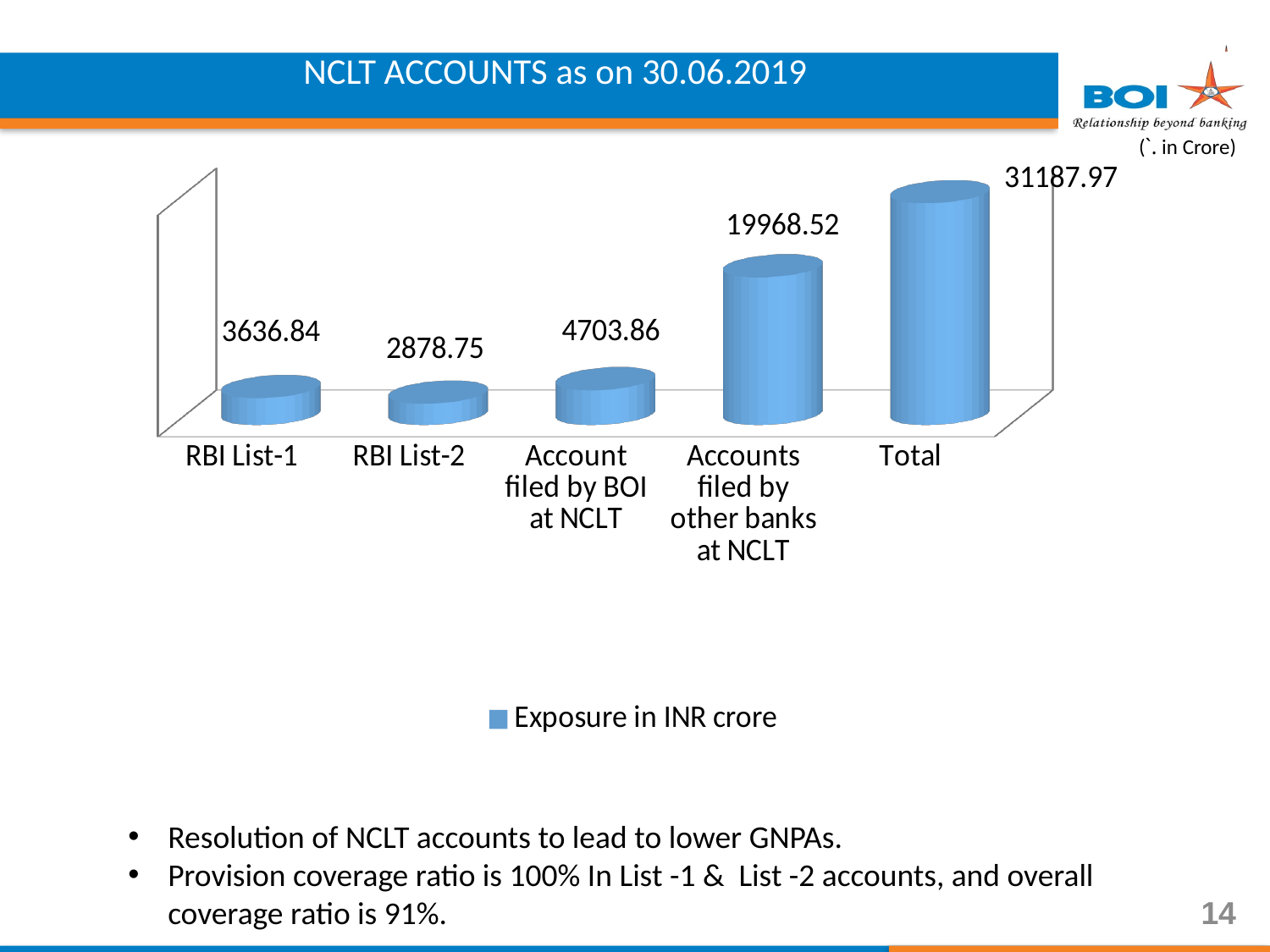
What is the difference between the values for RBI List-1 and RBI List-2? 758.09 Which category has the lowest value? RBI List-2 Which is larger, the value for RBI List-1 or the value for Account filed by BOI at NCLT? Account filed by BOI at NCLT What kind of chart is shown on the slide? Bar chart What is the difference between Accounts filed by other banks at NCLT and Account filed by BOI at NCLT? 15264.66 How many series does the legend list? 1 What is the value for Accounts filed by other banks at NCLT? 19968.52 What is the value shown for Total? 31187.97 What is the value for Account filed by BOI at NCLT? 4703.86 Excluding Total, which category has the highest value? Accounts filed by other banks at NCLT How many categories are shown on the x axis? 5 What is the value for RBI List-1? 3636.84